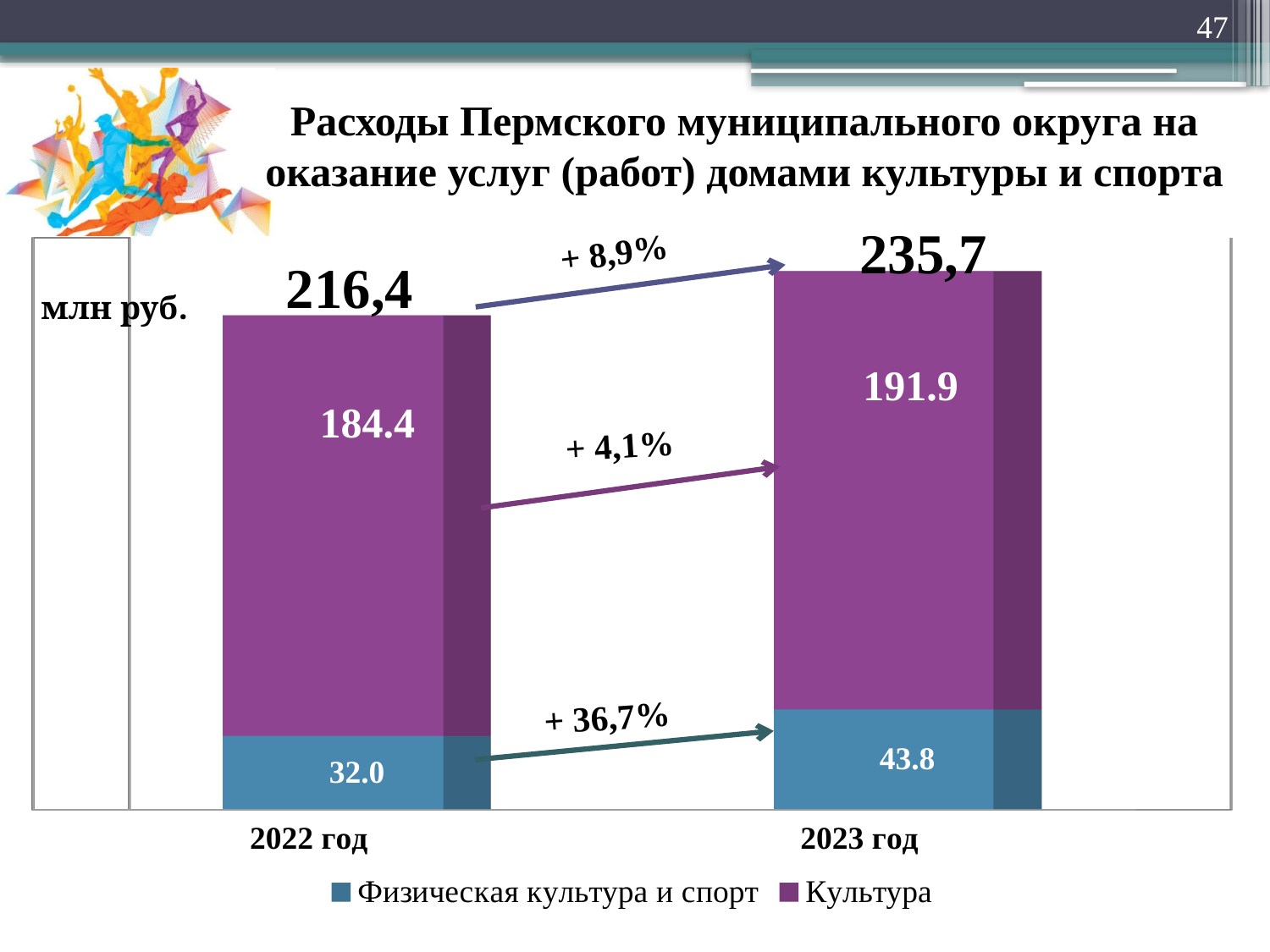
How many categories are shown on the x axis? 2 What is the total of the stacked bar for 2023 год as printed on the slide? 235,7 What is the value for Физическая культура и спорт in 2022 год? 32.0 What is the value for Культура in 2022 год? 184.4 Which year has the larger value for Физическая культура и спорт, 2022 год or 2023 год? 2023 год What percentage growth is shown for Физическая культура и спорт from 2022 год to 2023 год? + 36,7% What kind of chart is shown on the slide? Stacked bar chart What is the difference between the Культура values for 2023 год and 2022 год? 7.5 How many series does the legend list? 2 What is the value for Культура in 2023 год? 191.9 What is the value for Физическая культура и спорт in 2023 год? 43.8 What is the total of the stacked bar for 2022 год as printed on the slide? 216,4